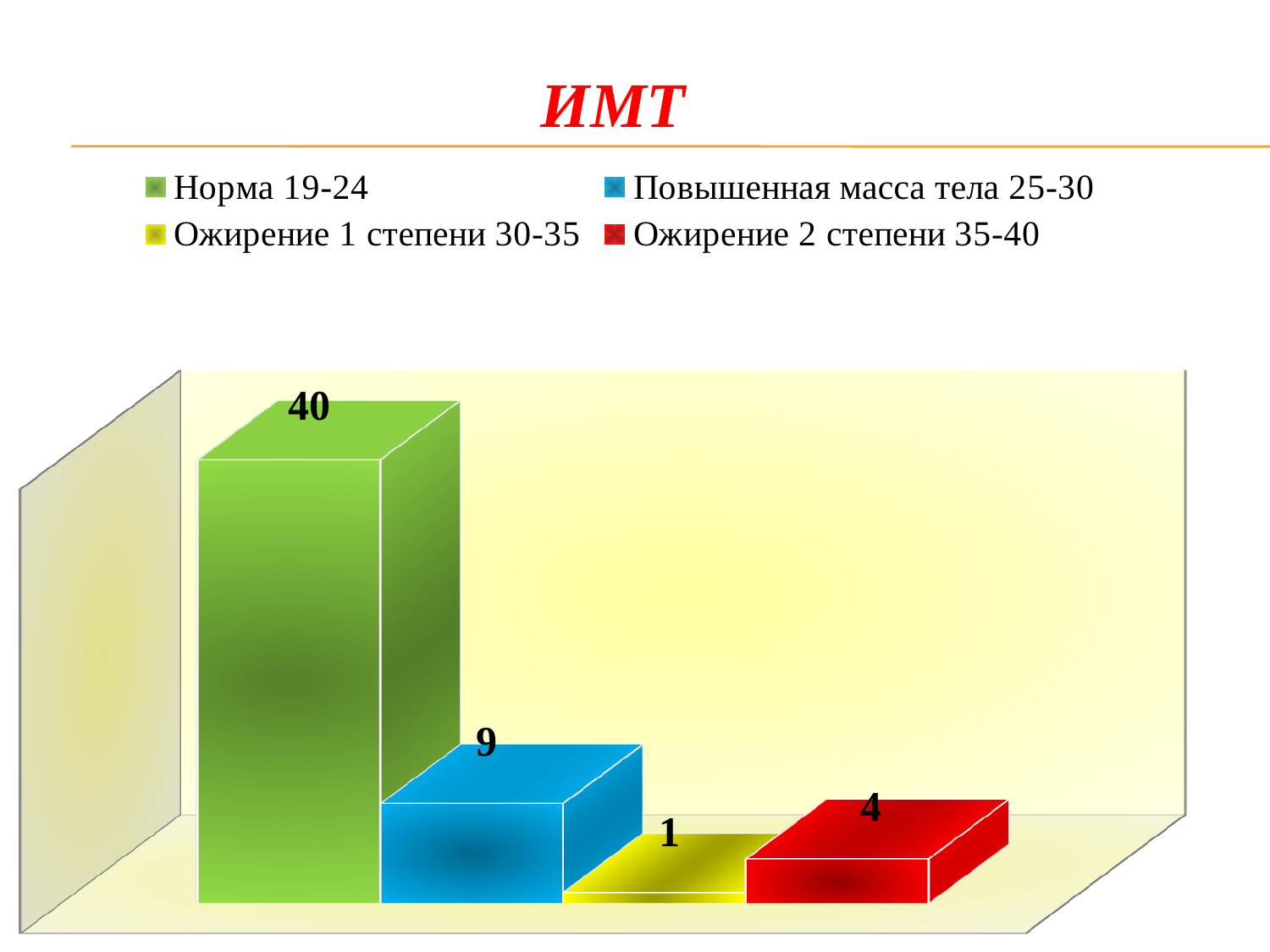
What is the value for Ожирение 2 степени 35-40? 4 What is the value for Ожирение 1 степени 30-35? 1 How many bars are shown in the chart? 4 Which is larger, the value for Повышенная масса тела 25-30 or Ожирение 2 степени 35-40? Повышенная масса тела 25-30 What is the value for Повышенная масса тела 25-30? 9 What kind of chart is shown on the slide? bar chart What is the value for Норма 19-24? 40 What is the difference between the values for Ожирение 2 степени 35-40 and Ожирение 1 степени 30-35? 3 What is the title of the chart? ИМТ Which category has the highest value? Норма 19-24 Which category has the lowest value? Ожирение 1 степени 30-35 What is the difference between the values for Норма 19-24 and Повышенная масса тела 25-30? 31